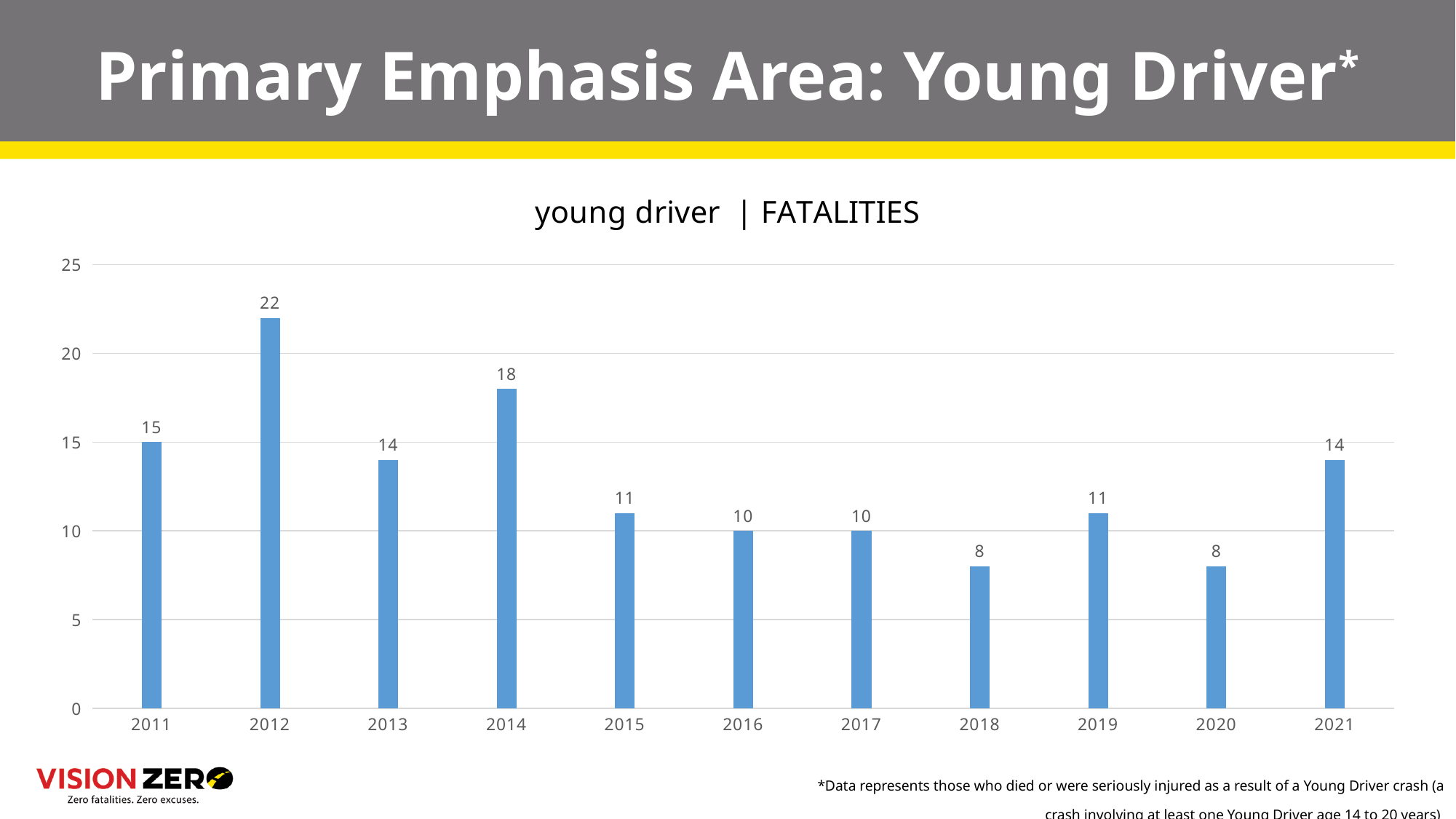
What is the difference between the values for 2012 and 2014? 4 What is the value for 2016? 10 What is the title of the chart? young driver | FATALITIES How many years are shown on the x axis? 11 Which years have the lowest value? 2018 and 2020 Which year has the highest value? 2012 What is the value for 2012? 22 What is the value for 2021? 14 Is the value for 2014 greater or less than 15? greater What kind of chart is shown on the slide? bar chart What is the difference between the values for 2011 and 2018? 7 Which is larger, the value for 2013 or the value for 2019? 2013